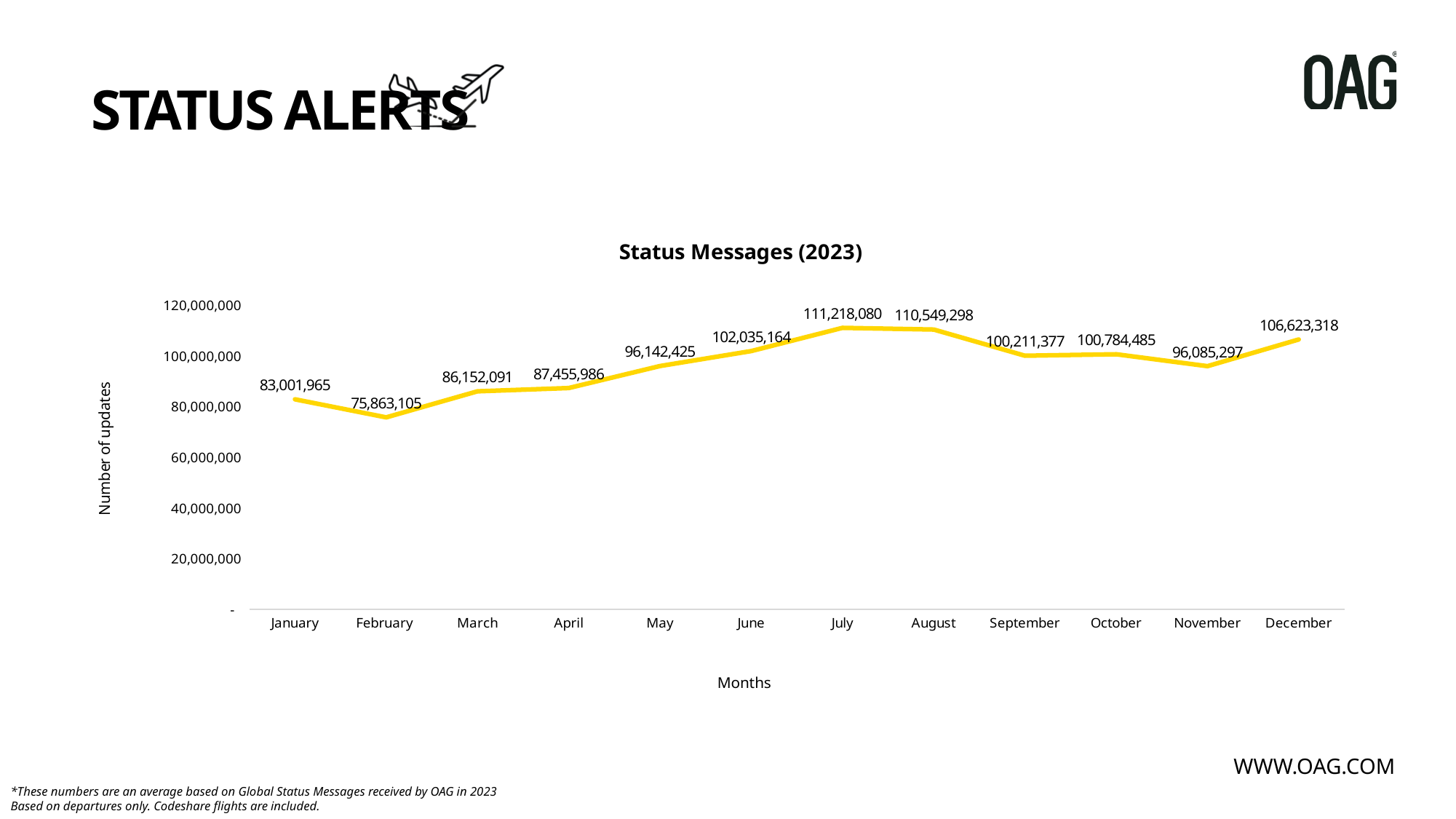
Which is larger, the value for July or the value for August? July What is the value for December in the Status Messages (2023) chart? 106,623,318 What is the value for February in the Status Messages (2023) chart? 75,863,105 From July to September, do the values rise or fall? fall Is the value for February greater or less than 80,000,000? less What is the difference between the July value and the February value? 35,354,975 How many months are plotted in the chart? 12 What is the difference between the December value and the November value? 10,538,021 What kind of chart is shown on the slide? line chart Which month has the lowest number of status messages? February Which month has the highest number of status messages? July What is the value for July in the Status Messages (2023) chart? 111,218,080